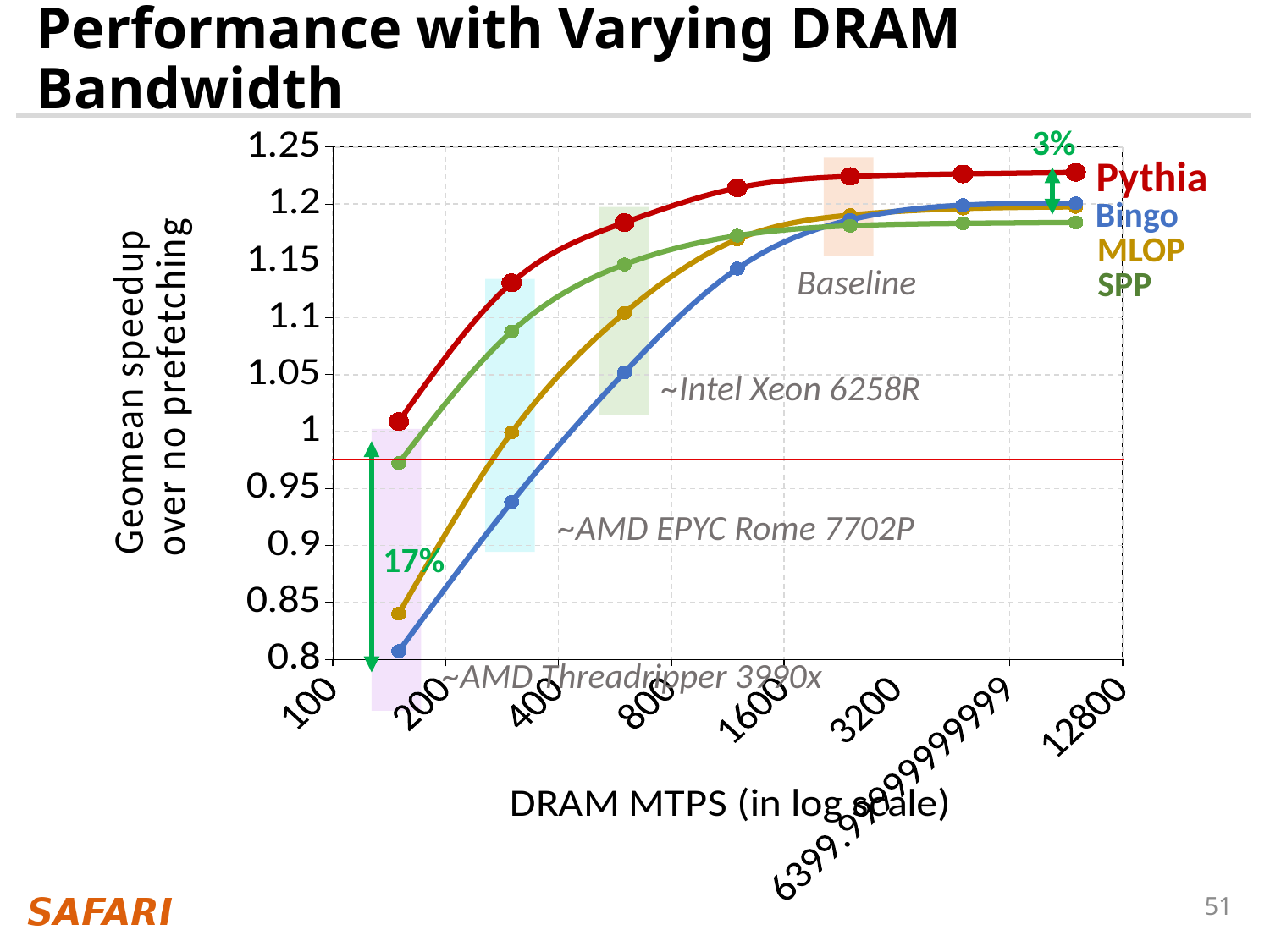
Which series has the highest speedup at the highest DRAM bandwidth point? Pythia Is Pythia's speedup at the highest DRAM bandwidth point greater or less than 1.2? greater What kind of chart is shown on the slide? line chart Which series has the highest speedup at the lowest DRAM bandwidth point? Pythia Do the speedup values rise or fall as DRAM bandwidth increases along the x axis? rise How many data points are plotted for each series? 7 Which series has the lowest speedup at the lowest DRAM bandwidth point? Bingo At the lowest DRAM bandwidth point, which is higher: SPP or MLOP? SPP What percentage improvement is annotated at the lowest DRAM bandwidth point? 17% How many series (prefetchers) are plotted in the chart? 4 Is Bingo's speedup at the lowest DRAM bandwidth point greater or less than 0.85? less Which series has the lowest speedup at the highest DRAM bandwidth point? SPP